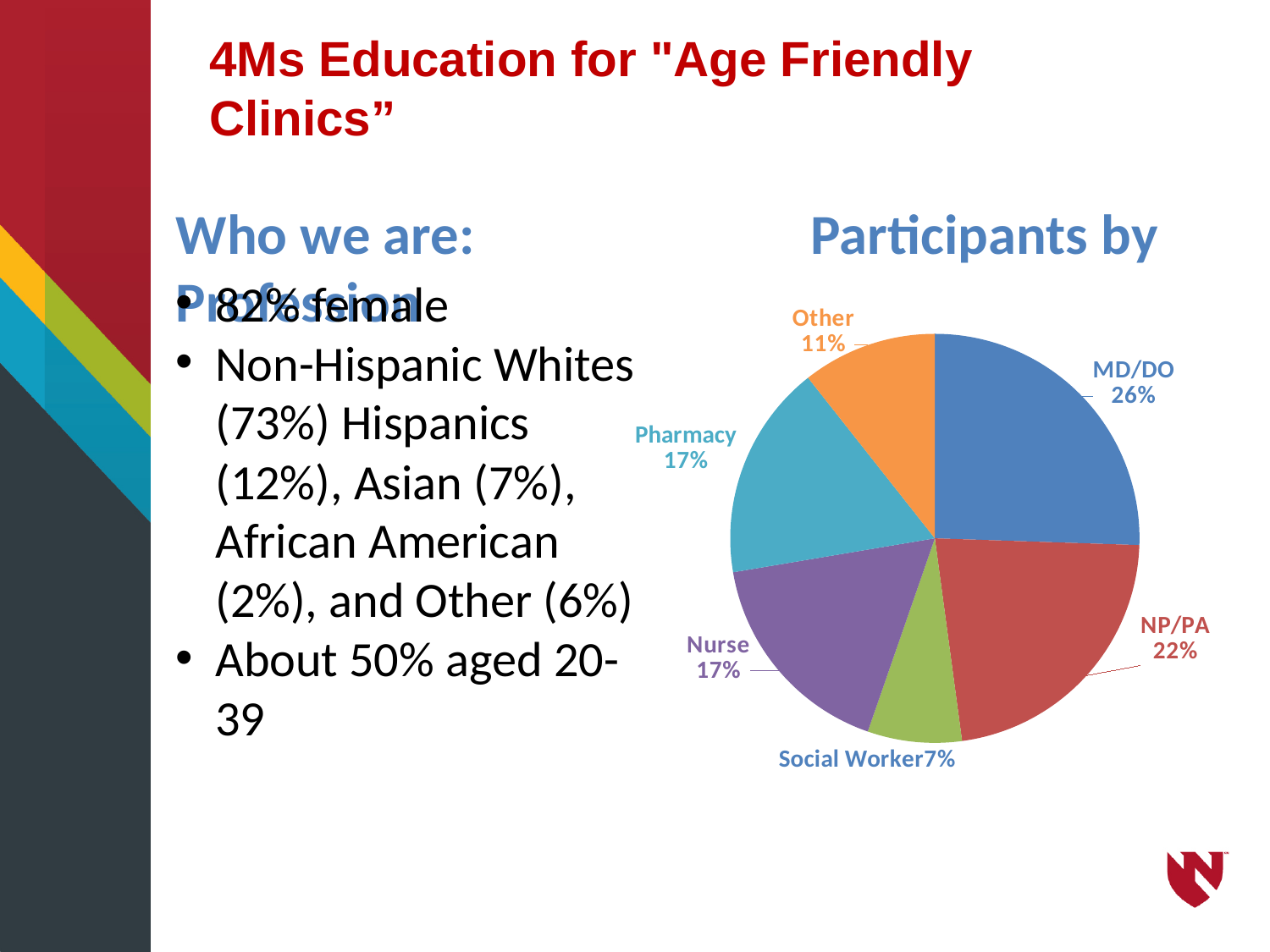
How many profession categories are shown in the pie chart? 6 Which profession has the smallest share of participants? Social Worker Which has a larger share of participants, NP/PA or Nurse? NP/PA What is the title of the chart? Participants by Profession What percentage of participants are Social Workers? 7% What percentage of participants fall under Other? 11% What share of participants are MD/DO? 26% What percentage of participants are NP/PA? 22% What is the difference in percentage points between the MD/DO and NP/PA shares? 4 What kind of chart is shown on the slide? pie chart Which profession has the largest share of participants? MD/DO What percentage of participants are in Pharmacy? 17%